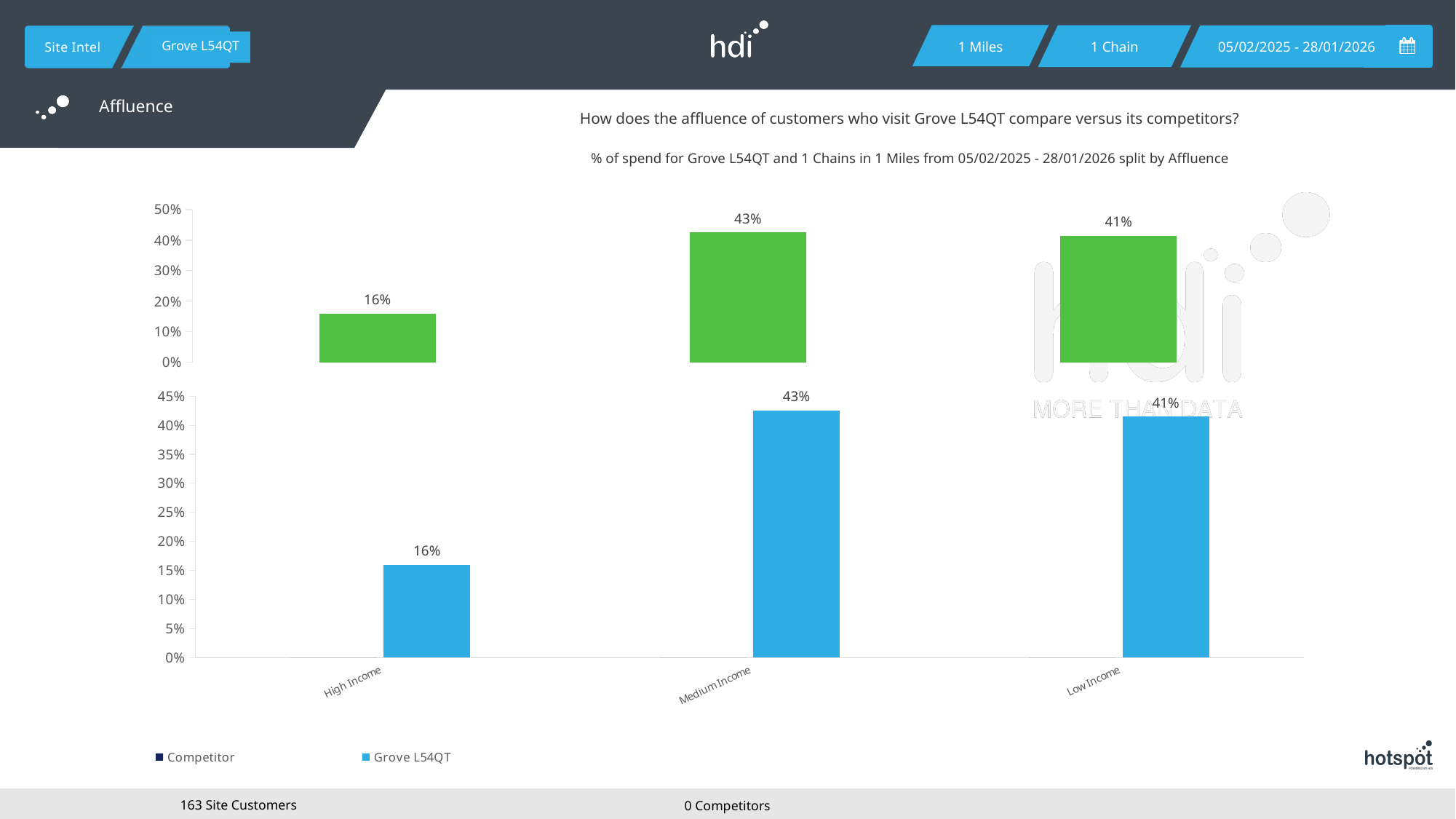
In the top chart, what is the difference between the Medium Income and Low Income values? 2% How many categories are shown on the x axis of the bottom chart? 3 In the top chart, which category has the lowest value? High Income In the bottom chart, what is the difference between the Medium Income and High Income values? 27% In the top chart, what is the value for Low Income? 41% In the bottom chart, which is larger, the value for Low Income or the value for High Income? Low Income In the bottom chart, what is the value for Medium Income? 43% In the bottom chart, which category has the highest value? Medium Income In the bottom chart, what is the value for High Income? 16% How many series does the legend list? 2 What kind of chart is the bottom chart? Bar chart In the top chart, what is the value for High Income? 16%